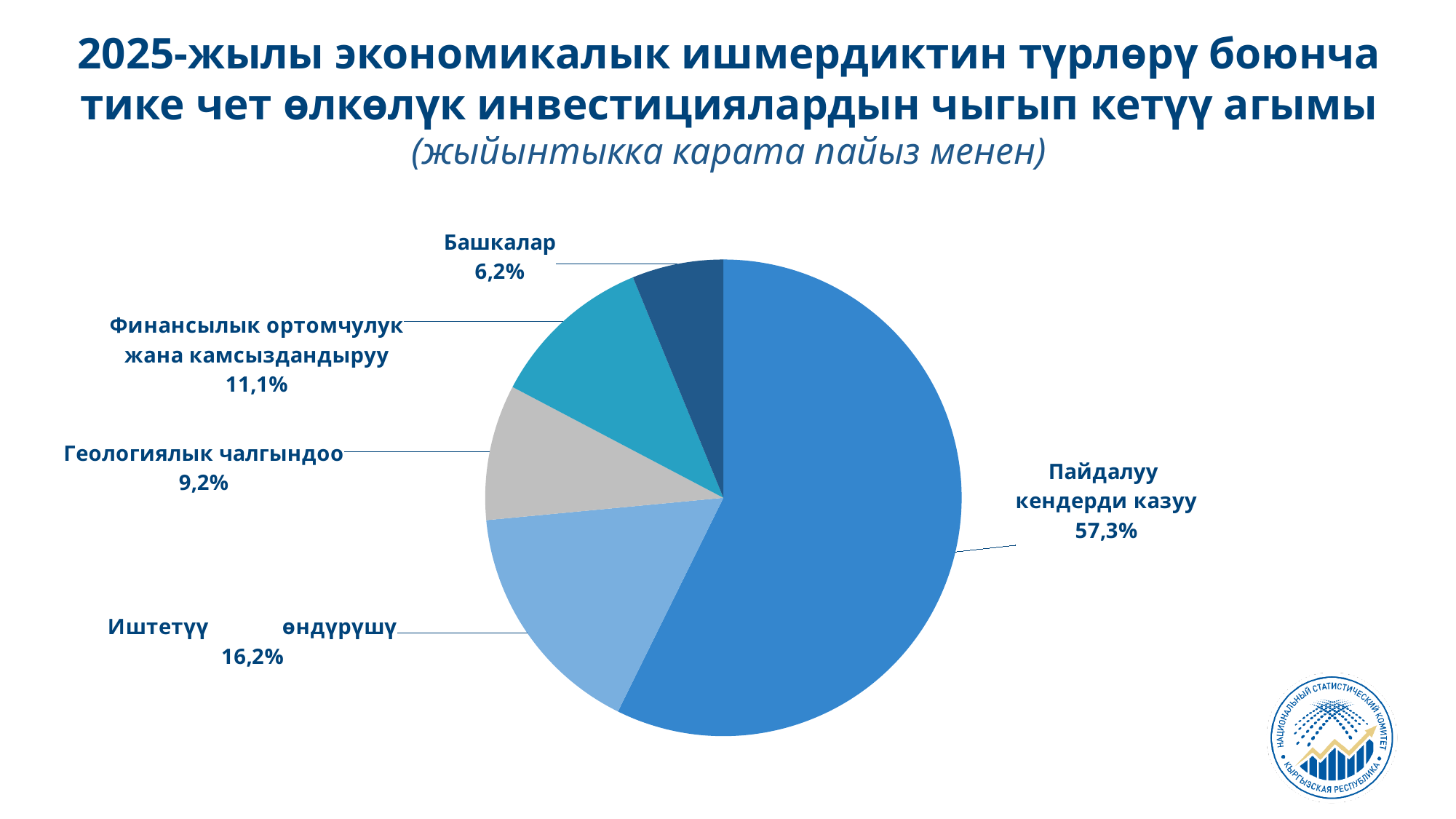
Which category has the largest share of the pie? Пайдалуу кендерди казуу What is the share for Пайдалуу кендерди казуу? 57,3% Which is larger: the share for Финансылык ортомчулук жана камсыздандыруу or the share for Геологиялык чалгындоо? Финансылык ортомчулук жана камсыздандыруу What is the share for Финансылык ортомчулук жана камсыздандыруу? 11,1% What does the subtitle in parentheses under the chart title say? (жыйынтыкка карата пайыз менен) What is the share for Иштетүү өндүрүшү? 16,2% What kind of chart is shown on the slide? Pie chart What is the share for Башкалар? 6,2% Which category has the smallest share of the pie? Башкалар How many slices does the pie chart have? 5 What is the share for Геологиялык чалгындоо? 9,2% What is the difference in percentage points between Пайдалуу кендерди казуу and Иштетүү өндүрүшү? 41,1